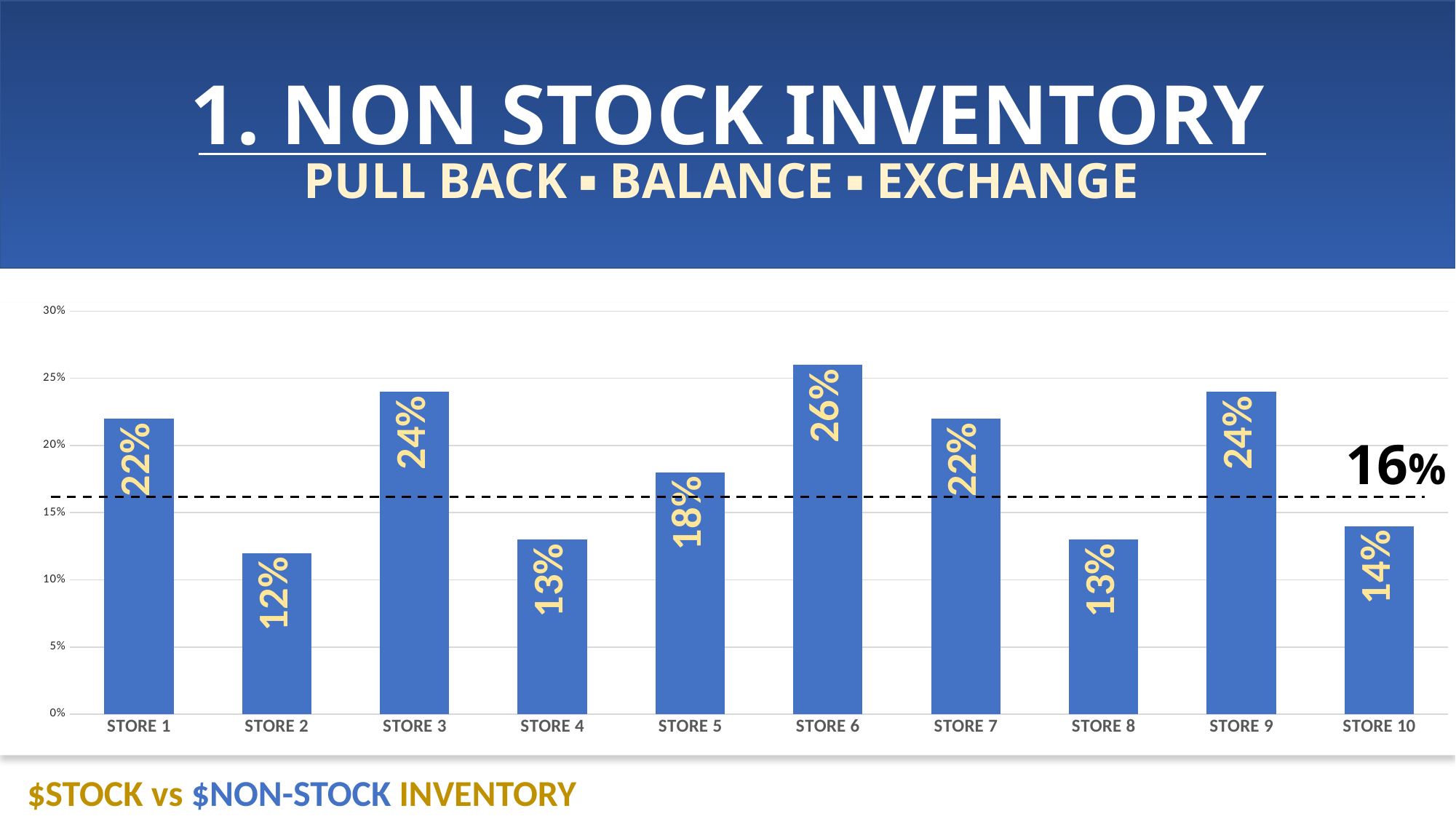
What kind of chart is shown on the slide? bar chart What is the value for STORE 6? 26% Which store has the highest value? STORE 6 Is the value for STORE 4 greater or less than 15%? less What is the value for STORE 10? 14% What value is marked by the dashed horizontal line on the chart? 16% Which is larger, the value for STORE 5 or the value for STORE 8? STORE 5 How many stores are shown on the chart? 10 How many stores have a value above the 16% dashed line? 6 What is the value for STORE 2? 12% What is the difference between the values for STORE 6 and STORE 2? 14% Which store has the lowest value? STORE 2